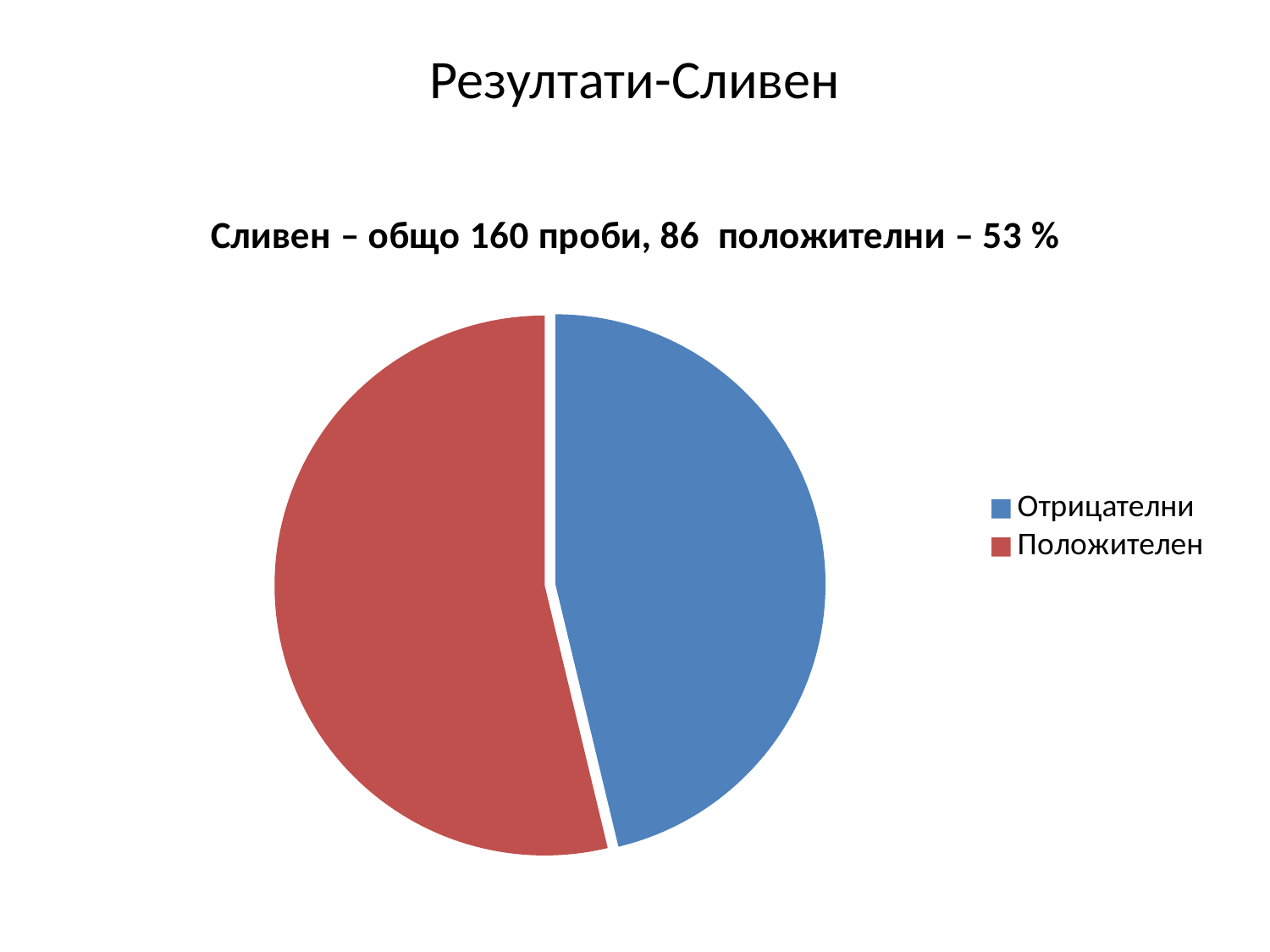
What is the title of the pie chart? Сливен – общо 160 проби, 86 положителни – 53 % What colour is the Отрицателни slice in the pie chart? blue What share of the pie does the Положителен slice represent, according to the chart title? 53 % How many entries does the legend of the pie chart list? 2 Using the total of 160 samples and 86 positive samples given in the chart title, how many samples were negative? 74 What kind of chart is shown on the slide? pie chart Which slice of the pie chart is the largest? Положителен Which slice is larger, Отрицателни or Положителен? Положителен How many slices does the pie chart have? 2 Which slice of the pie chart is the smallest? Отрицателни According to the chart title, how many samples were positive (положителни)? 86 According to the chart title, how many samples (проби) were tested in total in Сливен? 160